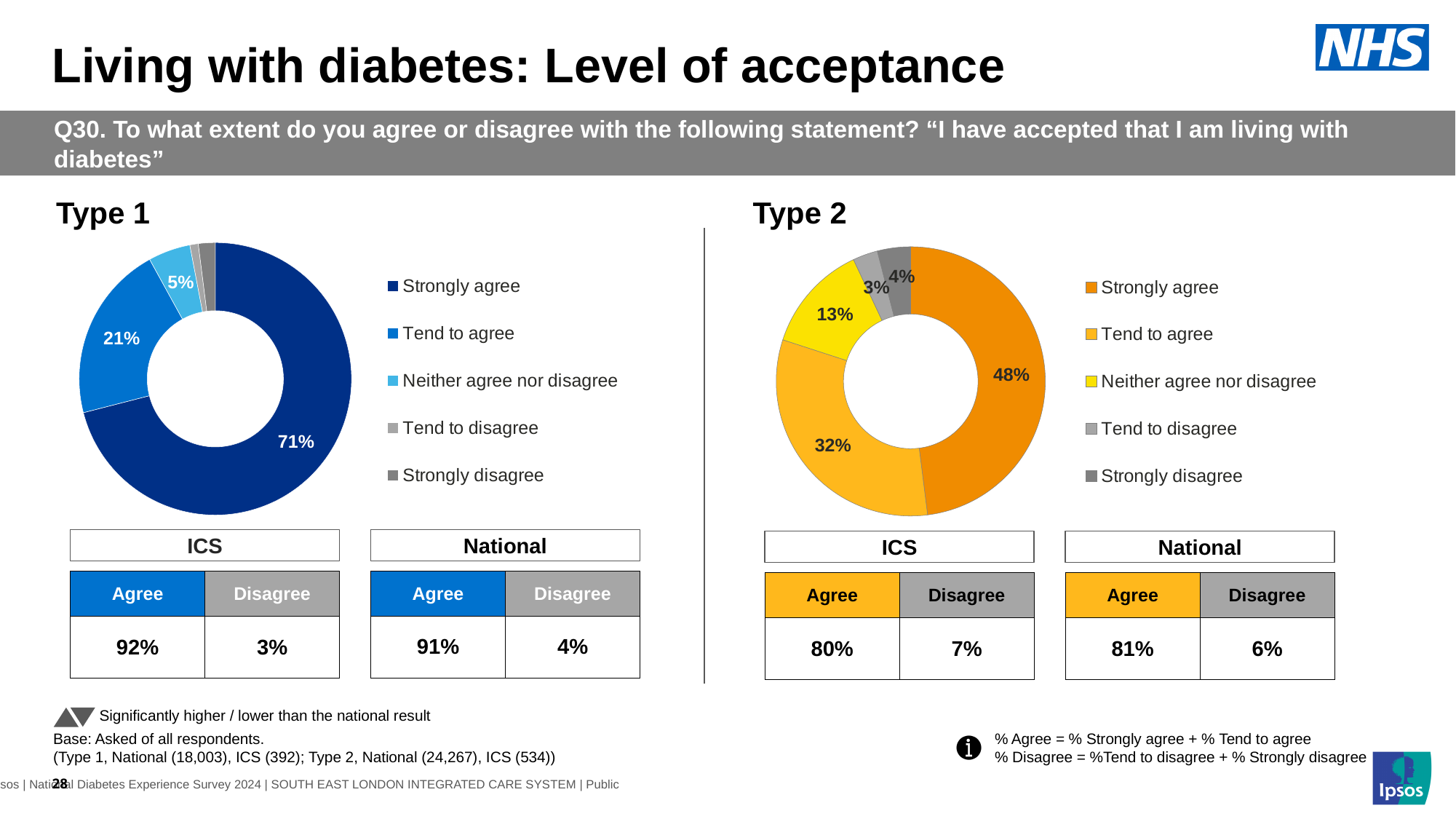
In the Type 2 chart, what percentage of respondents strongly agree? 48% What kind of chart is used for Type 1? Donut chart In the Type 1 chart, what is the difference between the Strongly agree and Tend to agree shares? 50% How many response categories does the legend of the Type 2 chart list? 5 In the Type 2 chart, which response category has the smallest share? Tend to disagree In the Type 2 chart, what is the difference between the Strongly agree and Tend to agree shares? 16% Which chart has the larger Strongly agree share, Type 1 or Type 2? Type 1 In the Type 1 chart, what percentage of respondents strongly agree? 71% In the Type 2 chart, what percentage of respondents neither agree nor disagree? 13% In the Type 1 chart, which response category has the largest share? Strongly agree In the Type 1 chart, what percentage of respondents tend to agree? 21% In the Type 2 chart, what percentage of respondents strongly disagree? 4%